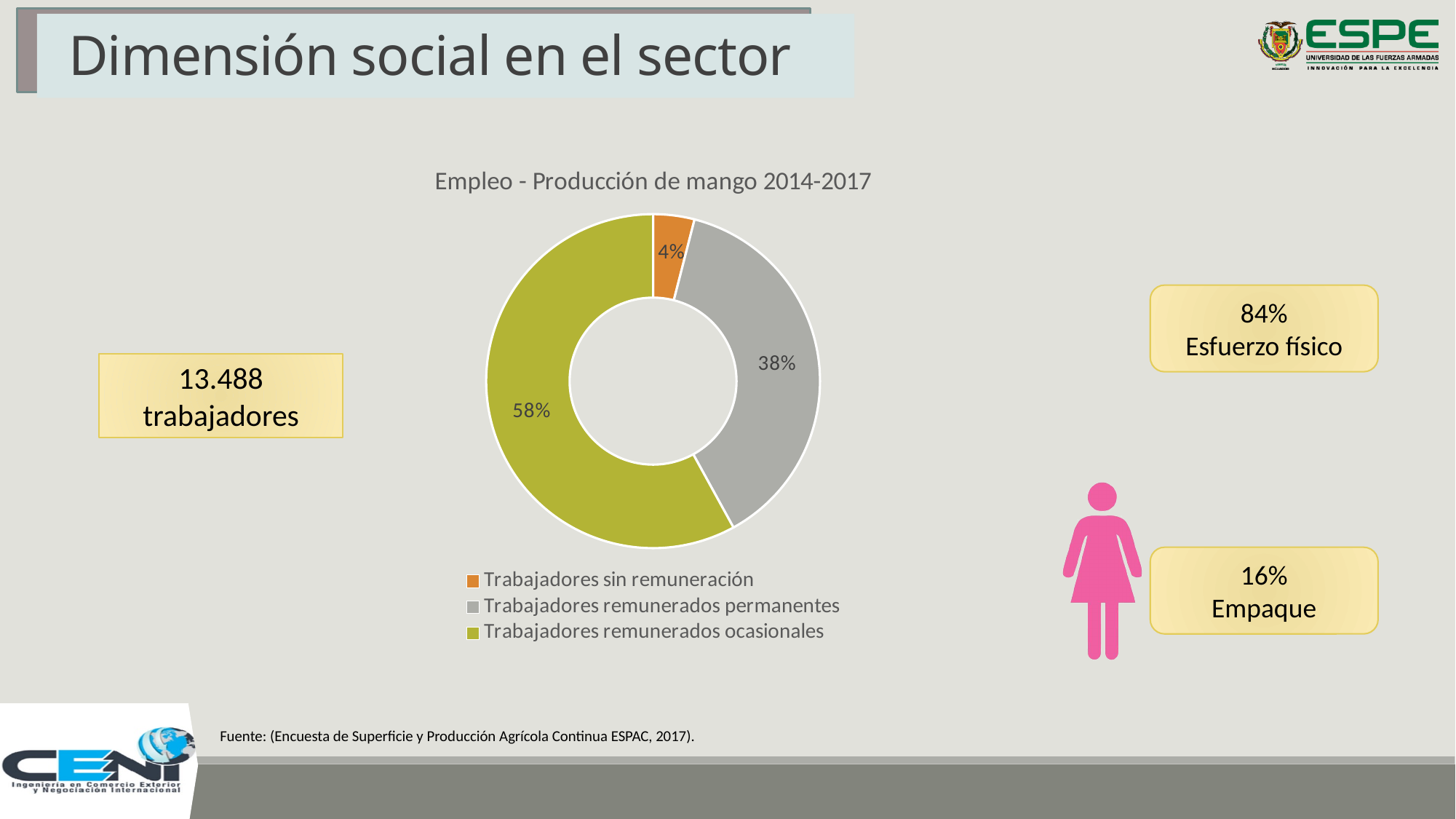
What percentage of the chart is Trabajadores remunerados permanentes? 38% What percentage of the chart is Trabajadores remunerados ocasionales? 58% How many categories does the chart show? 3 Which category has the largest share of the chart? Trabajadores remunerados ocasionales What is the title of the chart? Empleo - Producción de mango 2014-2017 What is the difference in percentage points between Trabajadores remunerados ocasionales and Trabajadores remunerados permanentes? 20 Which category has the smallest share of the chart? Trabajadores sin remuneración What percentage of the chart is Trabajadores sin remuneración? 4% Which is larger, the share for Trabajadores remunerados permanentes or Trabajadores sin remuneración? Trabajadores remunerados permanentes What colour represents Trabajadores sin remuneración in the chart? Orange What type of chart is shown on the slide? Doughnut chart What is the combined share of Trabajadores remunerados permanentes and Trabajadores sin remuneración? 42%